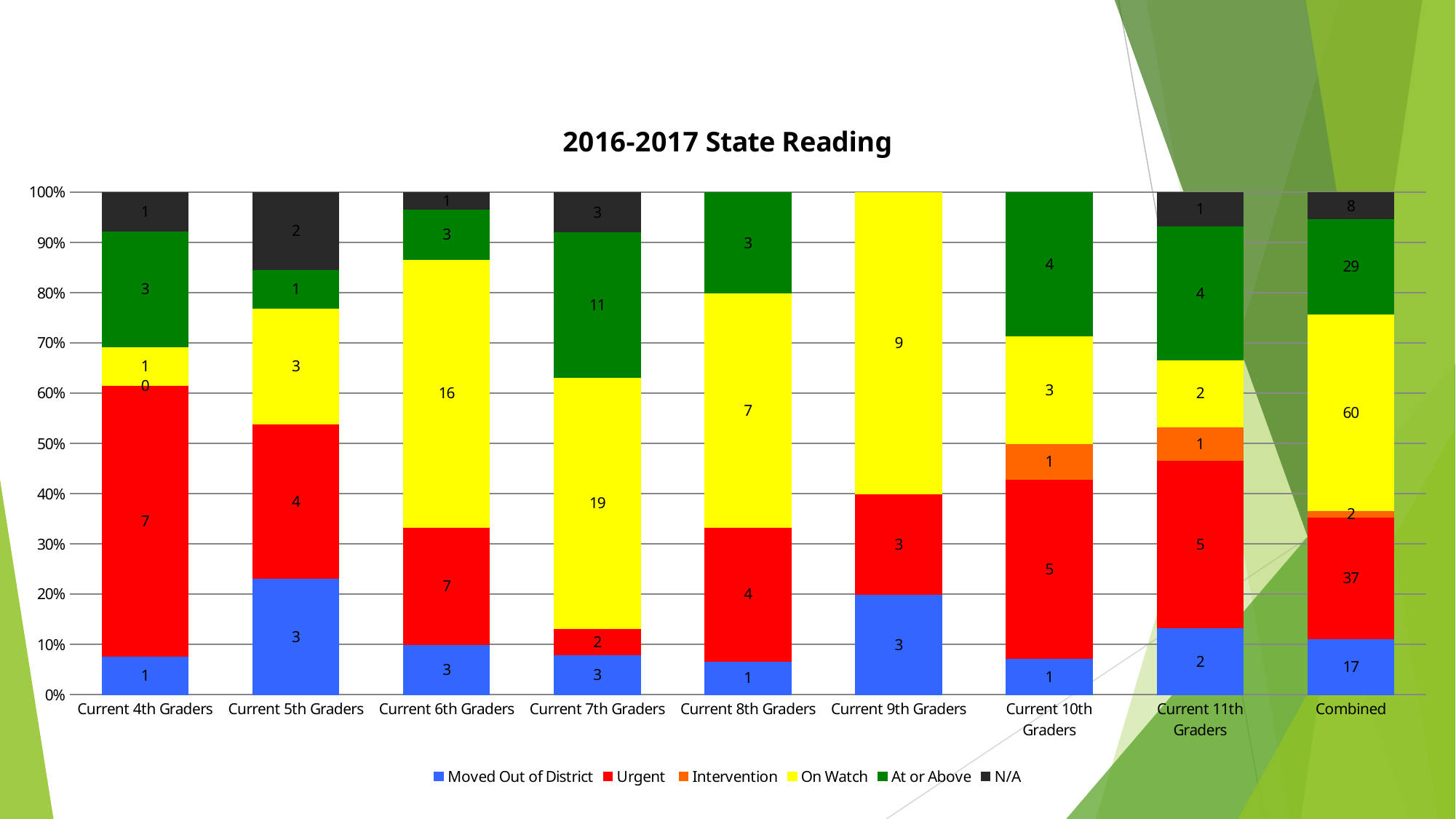
What is the Urgent value labelled for the Combined bar? 37 Excluding the Combined bar, which grade has the largest On Watch value? Current 7th Graders How many series does the legend list? 6 What is the N/A value labelled for the Combined bar? 8 Which has the larger At or Above value, Current 6th Graders or Current 7th Graders? Current 7th Graders What is the total of all the labelled values in the Combined bar? 153 What kind of chart is shown on the slide? Stacked bar chart How many categories are shown along the x axis? 9 In the Combined bar, what is the difference between the On Watch value and the Urgent value? 23 What is the On Watch value labelled for Current 7th Graders? 19 What is the Moved Out of District value labelled for Current 5th Graders? 3 What is the title of the chart? 2016-2017 State Reading